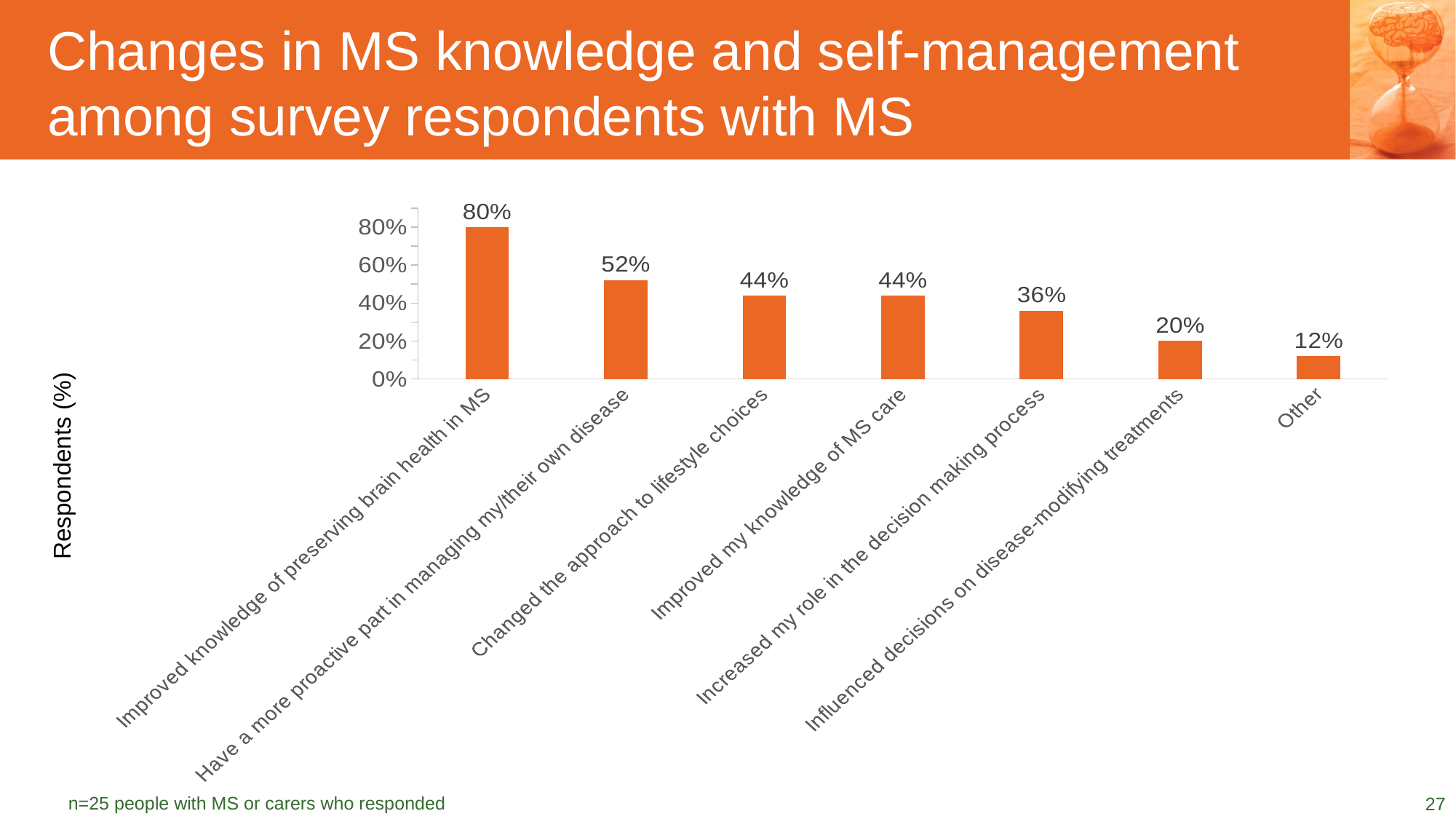
What is the value for 'Influenced decisions on disease-modifying treatments'? 20% Which is larger: 'Increased my role in the decision making process' or 'Influenced decisions on disease-modifying treatments'? Increased my role in the decision making process What percentage of respondents reported improved knowledge of preserving brain health in MS? 80% What kind of chart is shown on the slide? Bar chart How many categories are shown on the x axis? 7 What is the value for 'Other'? 12% Do the values rise or fall from left to right along the x axis? Fall What is the difference between 'Improved knowledge of preserving brain health in MS' and 'Have a more proactive part in managing my/their own disease'? 28% What percentage of respondents said they have a more proactive part in managing my/their own disease? 52% Which category has the highest percentage of respondents? Improved knowledge of preserving brain health in MS Which category has the lowest percentage of respondents? Other What is the label of the y axis? Respondents (%)